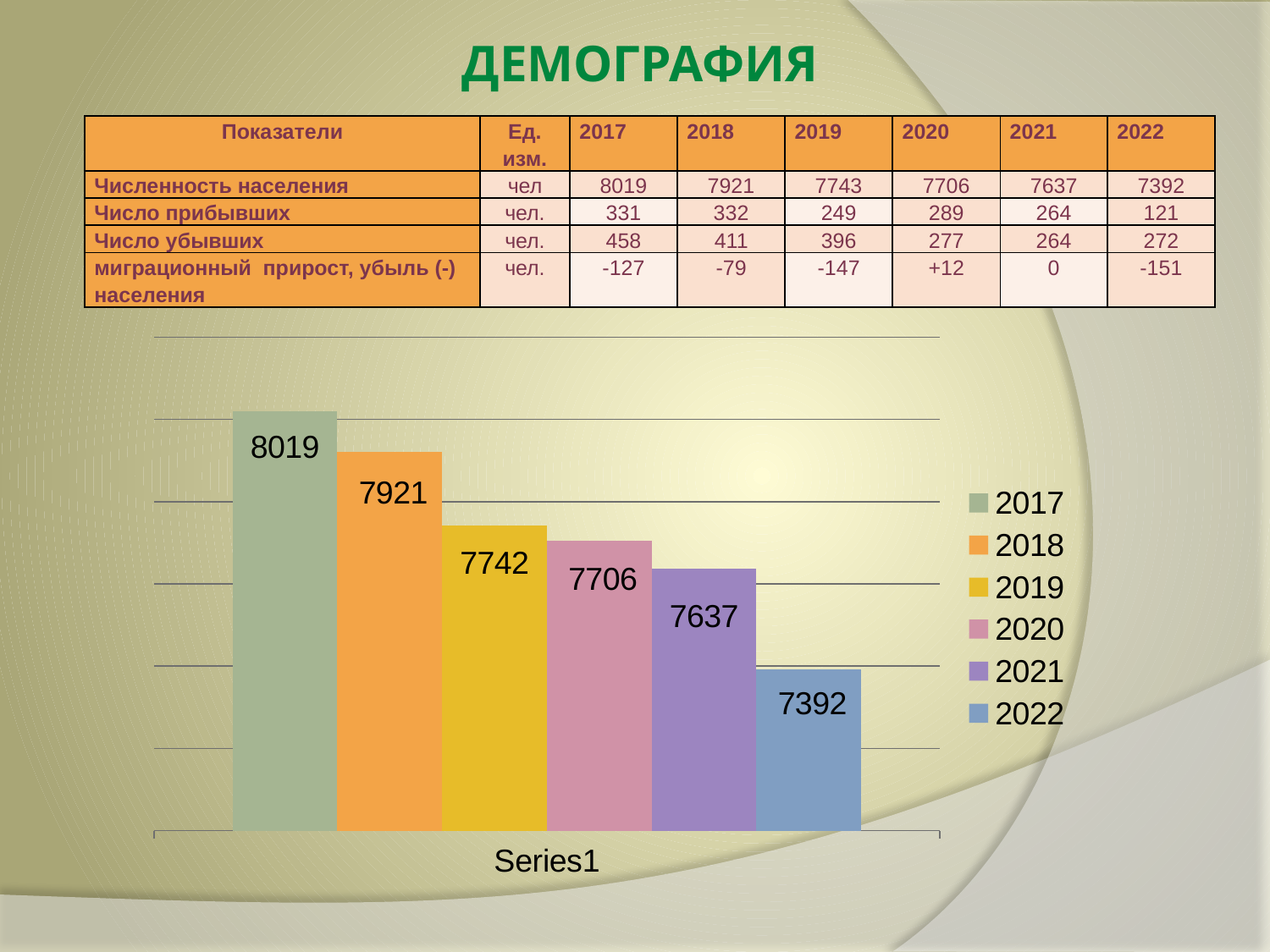
What type of chart is shown on the slide? bar chart What is the value of the bar for 2021? 7637 Which is larger, the value for 2020 or the value for 2021? 2020 Which year has the highest bar? 2017 How many entries does the legend list? 6 What is the value of the bar for 2019? 7742 What is the value of the bar for 2022? 7392 What is the difference between the values for 2017 and 2022? 627 Which year has the lowest bar? 2022 Do the bar values rise or fall from left to right? fall What is the difference between the values for 2018 and 2019? 179 What is the value of the bar for 2017? 8019